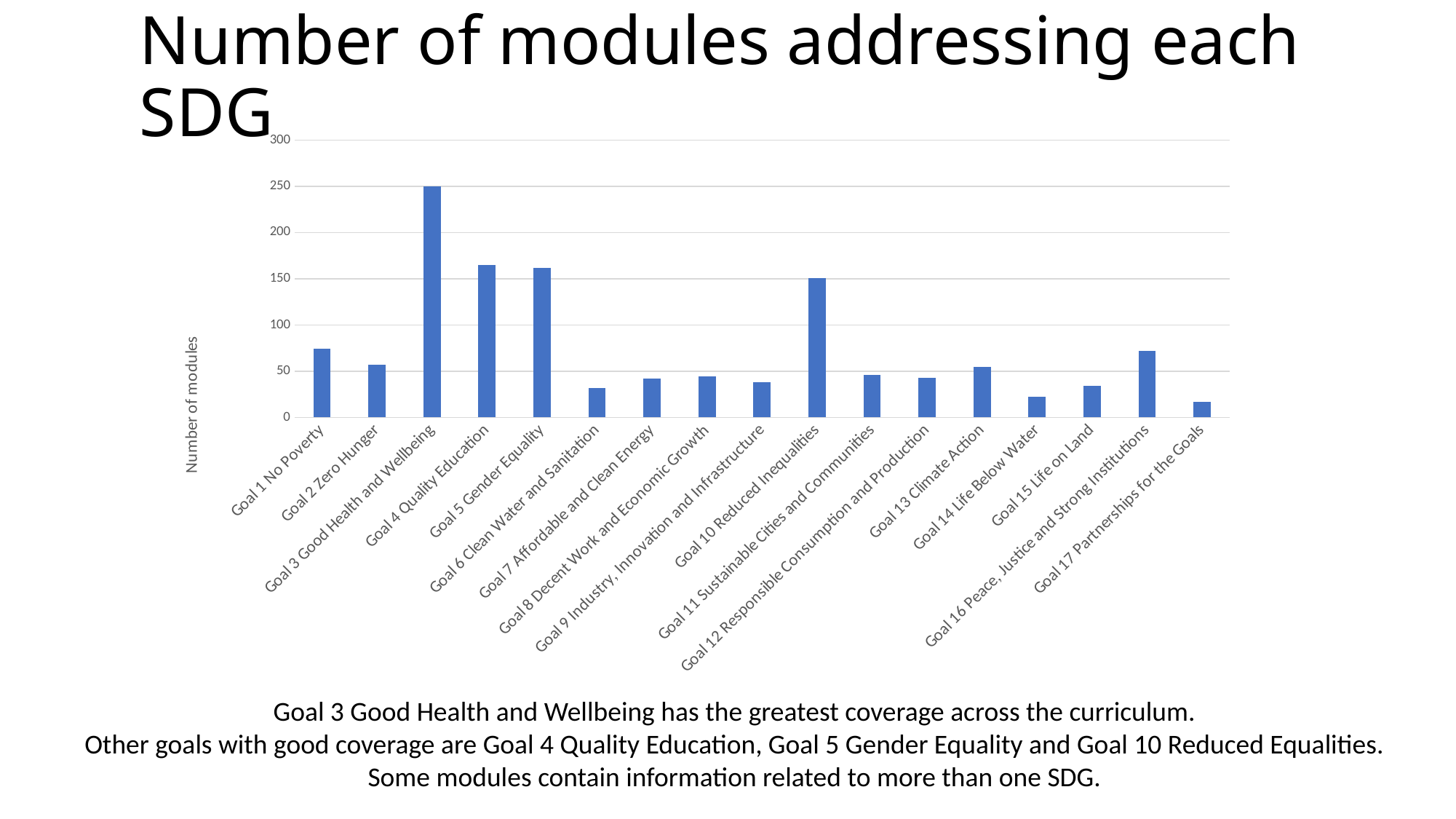
Is the value for Goal 10 Reduced Inequalities greater or less than 100? greater Which has more modules, Goal 2 Zero Hunger or Goal 14 Life Below Water? Goal 2 Zero Hunger Is the value for Goal 3 Good Health and Wellbeing greater or less than 200? greater What kind of chart is shown on the slide? bar chart Which SDG has the highest number of modules? Goal 3 Good Health and Wellbeing Which SDG has the lowest number of modules? Goal 17 Partnerships for the Goals What is the label on the vertical axis of the chart? Number of modules How many SDG categories are plotted on the chart? 17 Is the value for Goal 15 Life on Land greater or less than 50? less Which has more modules, Goal 4 Quality Education or Goal 6 Clean Water and Sanitation? Goal 4 Quality Education